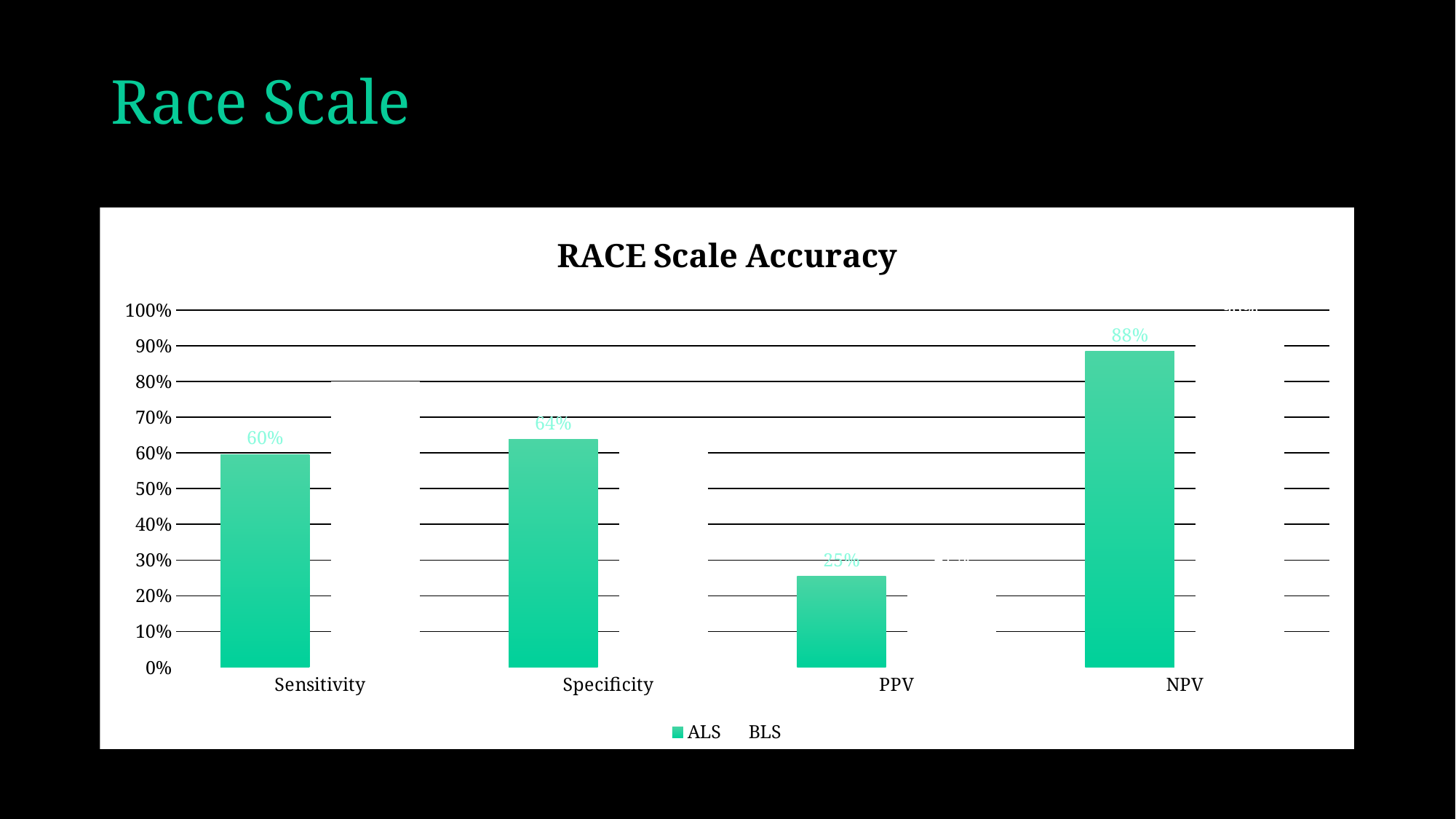
How many categories are shown on the x axis? 4 What is the ALS value for Specificity? 64% Which has a larger ALS value, Sensitivity or Specificity? Specificity What is the ALS value for NPV? 88% Which category has the highest ALS value? NPV What is the ALS value for Sensitivity? 60% What is the difference between the ALS values for NPV and PPV? 63% How many series does the legend list? 2 Is the ALS value for NPV greater or less than 80%? greater What is the ALS value for PPV? 25% Which category has the lowest ALS value? PPV What is the title of the chart? RACE Scale Accuracy